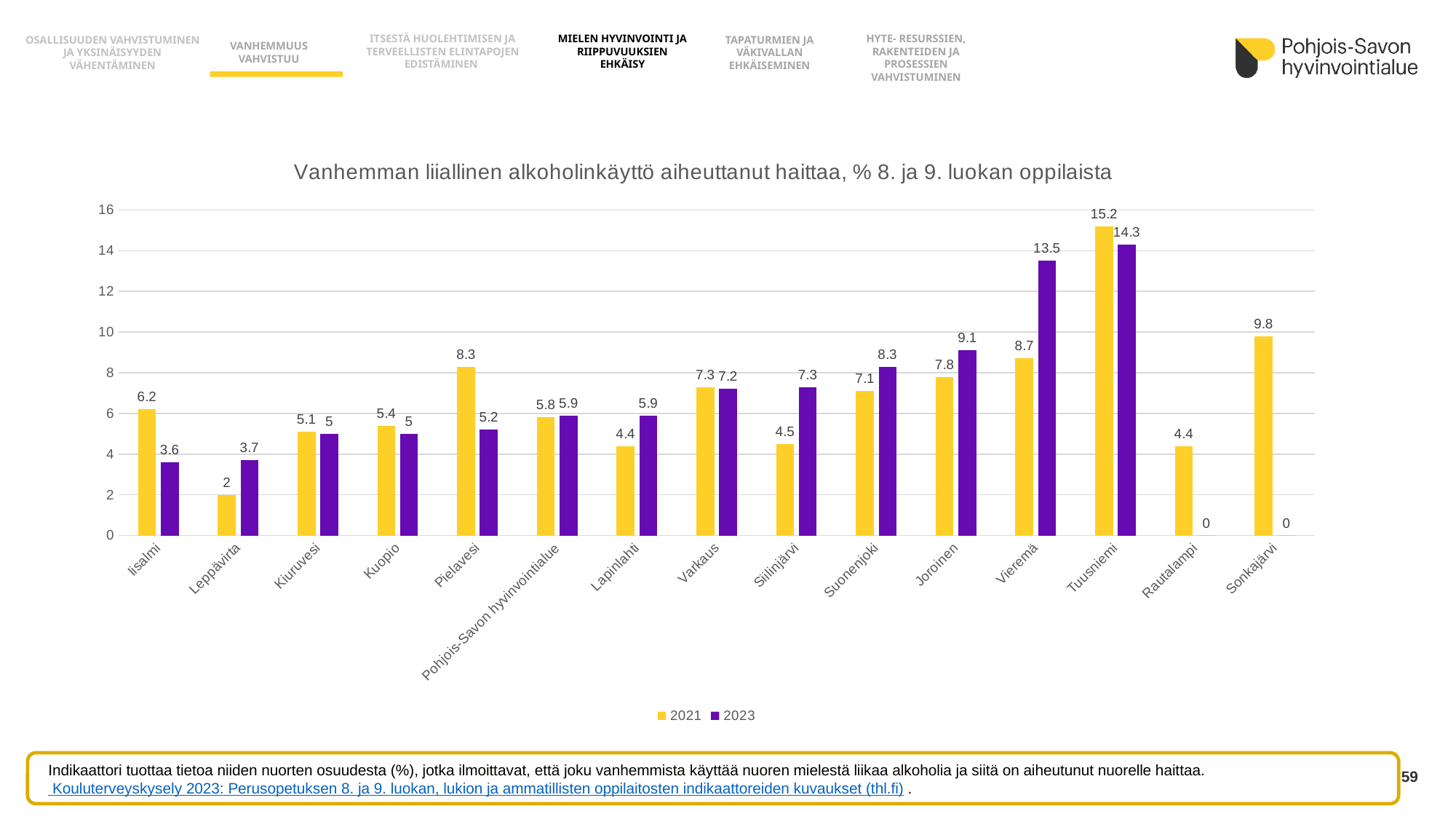
What is the difference between the 2021 and 2023 values for Pielavesi? 3.1 How many categories are shown on the x axis? 15 Which category has the lowest 2021 value? Leppävirta What kind of chart is shown on the slide? bar chart What is the 2021 value for Pohjois-Savon hyvinvointialue? 5.8 What is the 2023 value for Vieremä? 13.5 Which is larger for Siilinjärvi, the 2021 value or the 2023 value? 2023 What is the 2021 value for Tuusniemi? 15.2 Which category has the highest 2023 value? Tuusniemi Is the 2021 value for Sonkajärvi greater or less than 8? greater How many series does the legend list? 2 What colour represents the 2023 series? purple